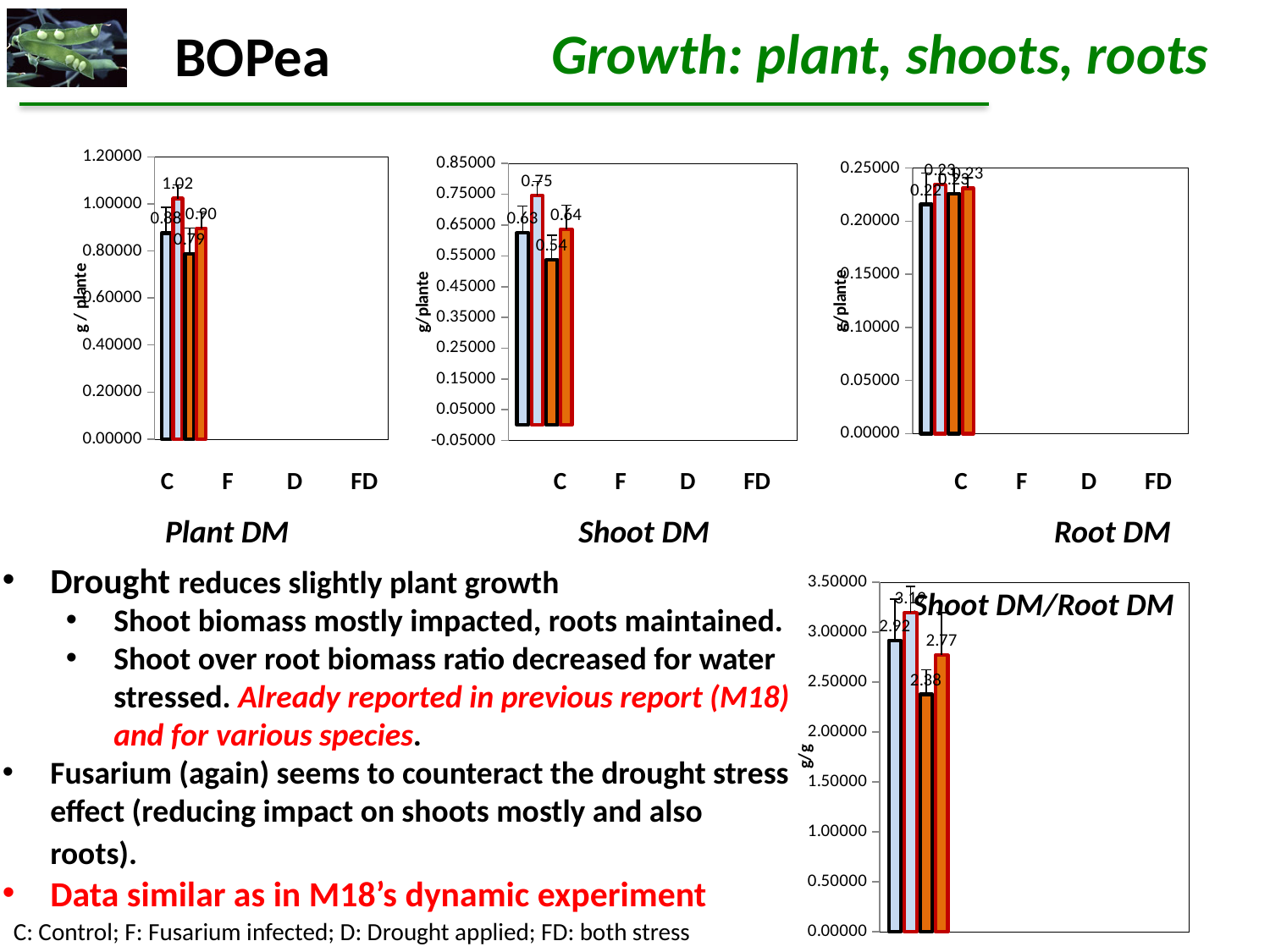
In the Plant DM chart, what is the value for F? 1.02 In the Shoot DM chart, which treatment has the highest value? F In the Shoot DM/Root DM chart, what is the value for C? 2.92 What type of chart is the Shoot DM chart? bar chart In the Plant DM chart, which is larger, the value for F or the value for D? F In the Shoot DM/Root DM chart, which treatment has the lowest value? D In the Shoot DM chart, what is the difference between the values for F and D? 0.21 In the Plant DM chart, which treatment has the lowest value? D How many bars are plotted in the Plant DM chart? 4 In the Shoot DM chart, what is the value for D? 0.54 In the Root DM chart, is the value for C greater or less than 0.20? greater In the Shoot DM/Root DM chart, what is the difference between the values for C and D? 0.54